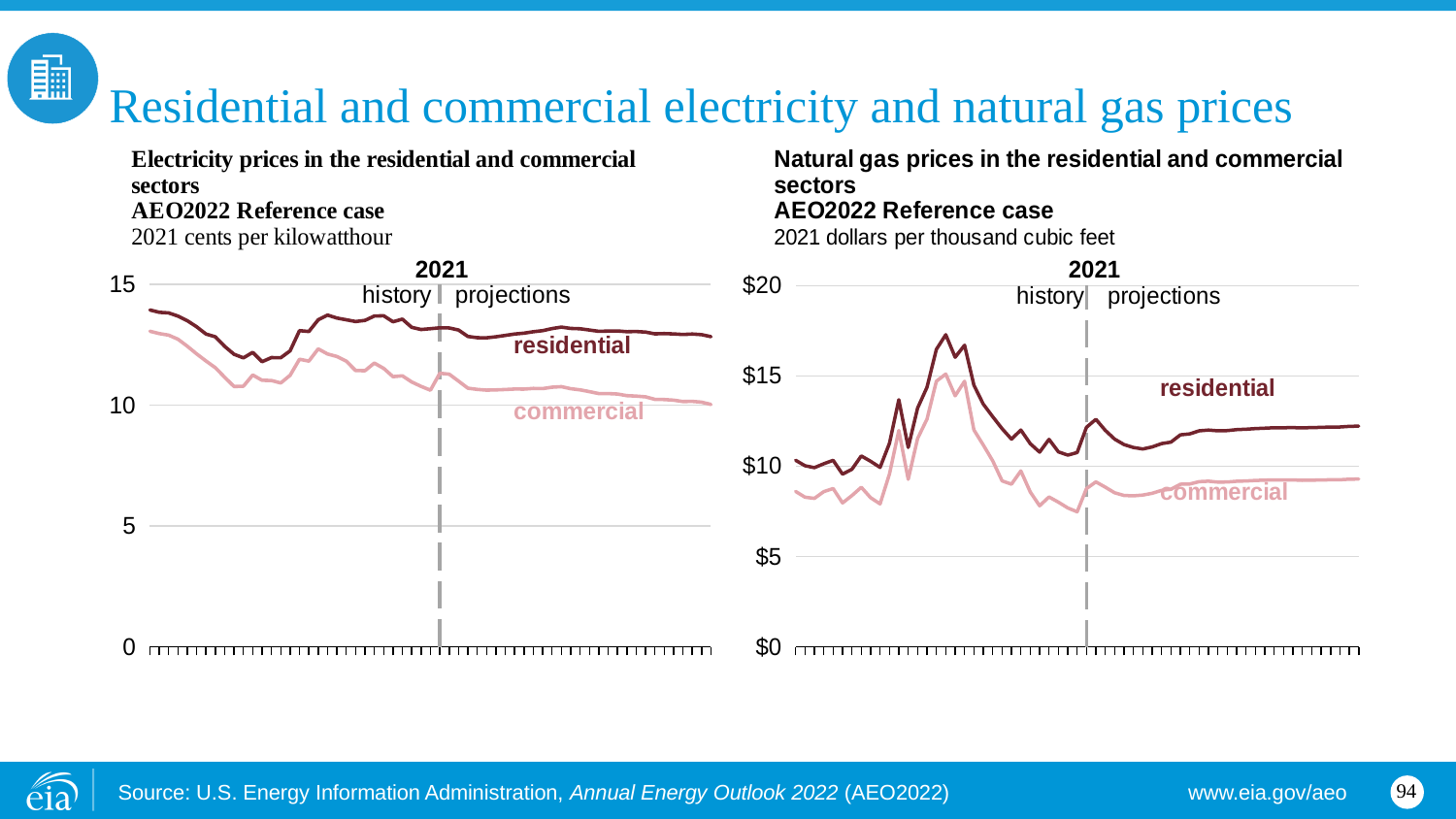
In the electricity prices chart, is the residential value at the end of the projection period greater or less than 10? greater In the natural gas prices chart, which series is higher at the end of the projection period, residential or commercial? residential What kind of chart is the 'Natural gas prices in the residential and commercial sectors' chart? line chart What kind of chart is the 'Electricity prices in the residential and commercial sectors' chart? line chart In the natural gas prices chart, is the commercial value at the end of the projection period greater or less than $10? less In the natural gas prices chart, how many series are plotted? 2 In the electricity prices chart, which series is higher throughout, residential or commercial? residential In the natural gas prices chart, is the peak residential value greater or less than $15? greater In the electricity prices chart, does the commercial series rise or fall over the projection period? fall In the electricity prices chart, how many series are plotted? 2 What year separates history from projections in both charts? 2021 What unit is used on the natural gas prices chart? 2021 dollars per thousand cubic feet